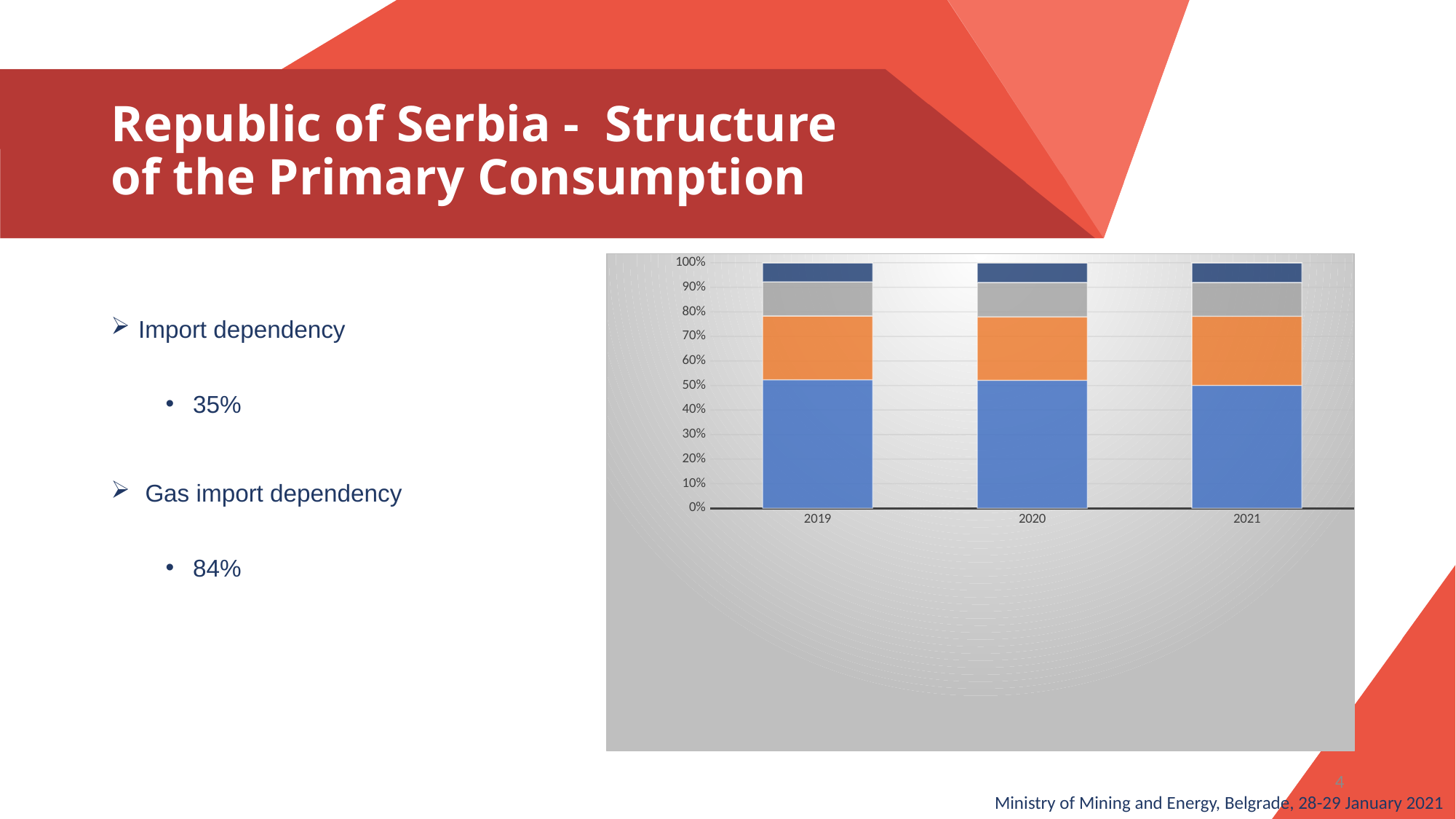
What is the highest value shown on the y axis of the chart? 100% Is the top of the orange segment for 2020 greater or less than 70%? greater Which years are shown on the x axis of the chart? 2019, 2020, 2021 Which coloured segment is the smallest in the 2020 bar? Dark blue (top) In the 2019 bar, which segment is larger: the blue segment or the orange segment? Blue How many coloured segments make up each bar in the chart? 4 Is the top of the orange segment for 2021 greater or less than 90%? less Is the top of the blue (bottom) segment for 2021 greater or less than 60%? less How many years are shown on the x axis of the chart? 3 Which coloured segment is the largest in every bar of the chart? Blue What kind of chart is shown on the slide? Stacked bar chart